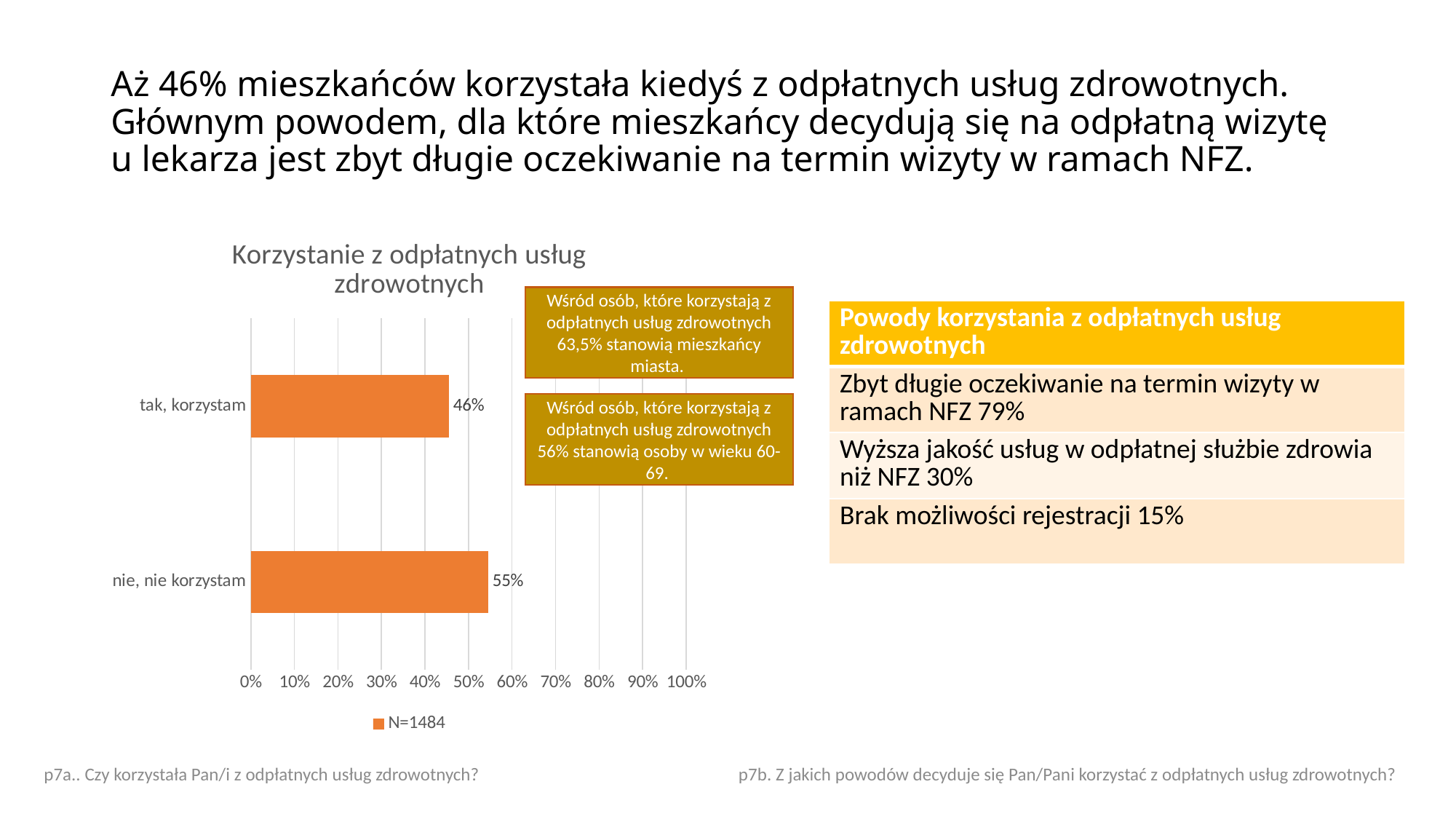
What is the difference between the values for "nie, nie korzystam" and "tak, korzystam" in the chart "Korzystanie z odpłatnych usług zdrowotnych"? 9% In the chart "Korzystanie z odpłatnych usług zdrowotnych", is the value for "nie, nie korzystam" greater or less than 50%? greater What is the value for "nie, nie korzystam" in the chart "Korzystanie z odpłatnych usług zdrowotnych"? 55% What is the legend entry of the chart "Korzystanie z odpłatnych usług zdrowotnych"? N=1484 How many categories are shown in the chart "Korzystanie z odpłatnych usług zdrowotnych"? 2 What kind of chart is "Korzystanie z odpłatnych usług zdrowotnych"? bar chart In the chart "Korzystanie z odpłatnych usług zdrowotnych", which is larger: "tak, korzystam" or "nie, nie korzystam"? nie, nie korzystam What is the value for "tak, korzystam" in the chart "Korzystanie z odpłatnych usług zdrowotnych"? 46% How many series does the legend of the chart "Korzystanie z odpłatnych usług zdrowotnych" list? 1 Which category has the lowest value in the chart "Korzystanie z odpłatnych usług zdrowotnych"? tak, korzystam In the chart "Korzystanie z odpłatnych usług zdrowotnych", is the value for "tak, korzystam" greater or less than 50%? less Which category has the highest value in the chart "Korzystanie z odpłatnych usług zdrowotnych"? nie, nie korzystam